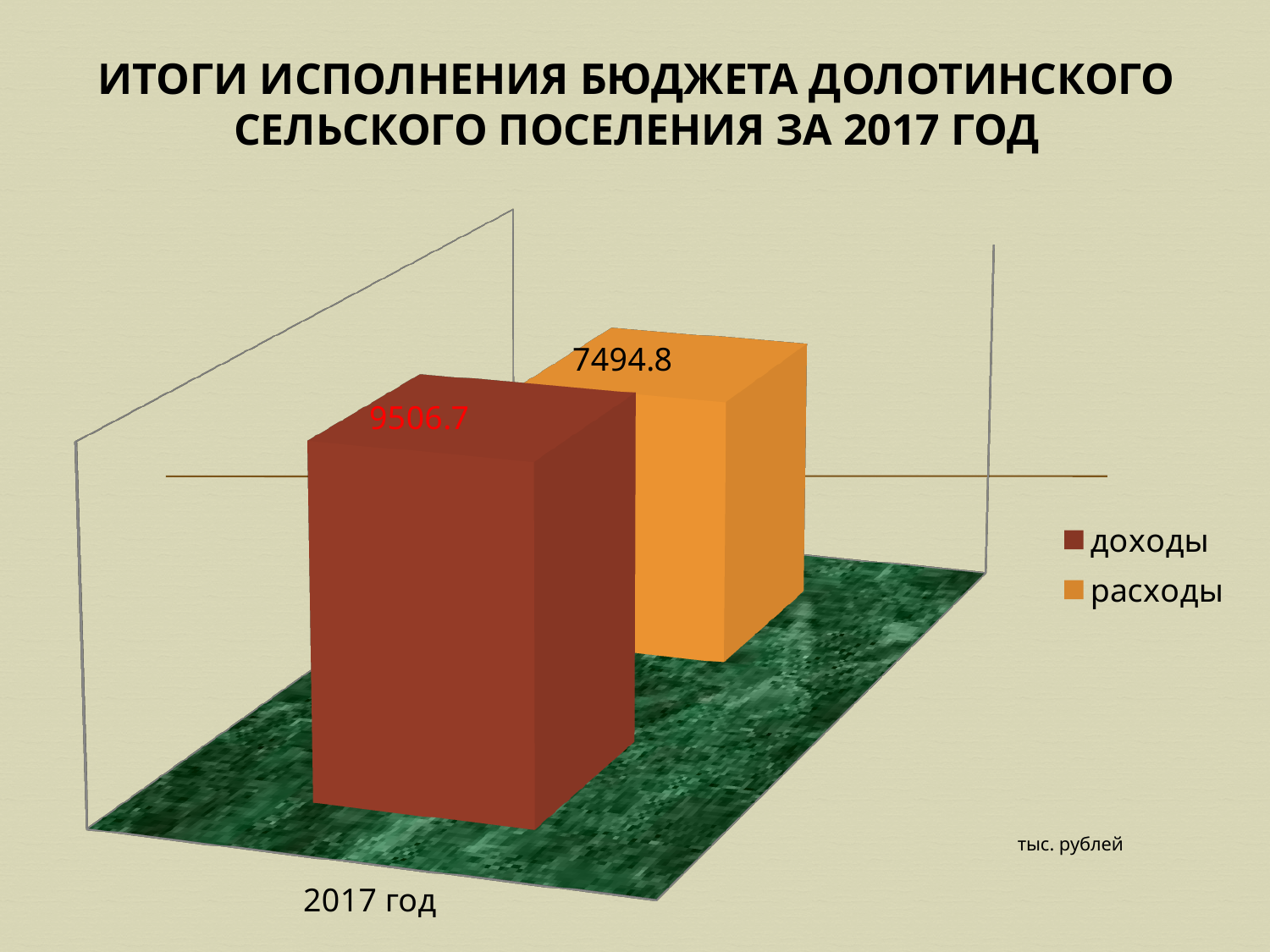
What unit is indicated for the values on the chart? тыс. рублей How many categories are shown on the x axis? 1 Which series has the highest value on the chart? доходы Which series has the lowest value on the chart? расходы How many series does the legend list? 2 What is the difference between доходы and расходы for 2017 год? 2011.9 What kind of chart is shown on the slide? bar chart Which series has the higher value, доходы or расходы? доходы What category label is shown on the x axis? 2017 год What is the value for расходы in 2017 год? 7494.8 What is the value for доходы in 2017 год? 9506.7